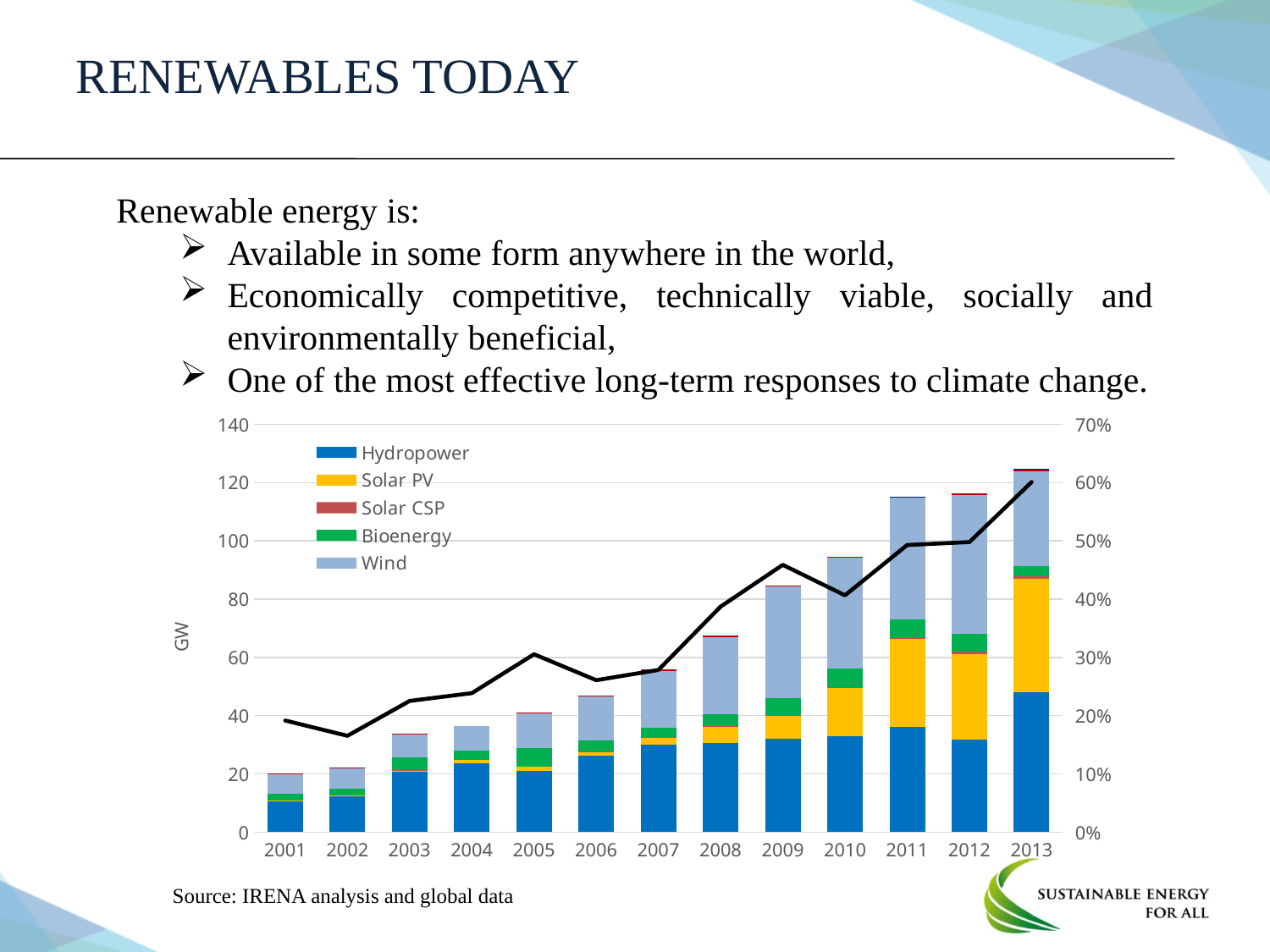
Which year has the tallest stacked bar in the chart? 2013 Is the total stacked bar value for 2001 greater or less than 40 GW? less Which year has the larger total stacked bar, 2010 or 2011? 2011 What kind of chart is shown on the slide? stacked bar chart with a line Is the total stacked bar value for 2013 greater or less than 120 GW? greater How many series does the chart's legend list? 5 Is the total stacked bar value for 2004 greater or less than 40 GW? less Do the total stacked bar values generally rise or fall from 2001 to 2013? rise What unit is shown on the left vertical axis of the chart? GW Which year has the shortest stacked bar in the chart? 2001 How many years are shown along the x axis of the chart? 13